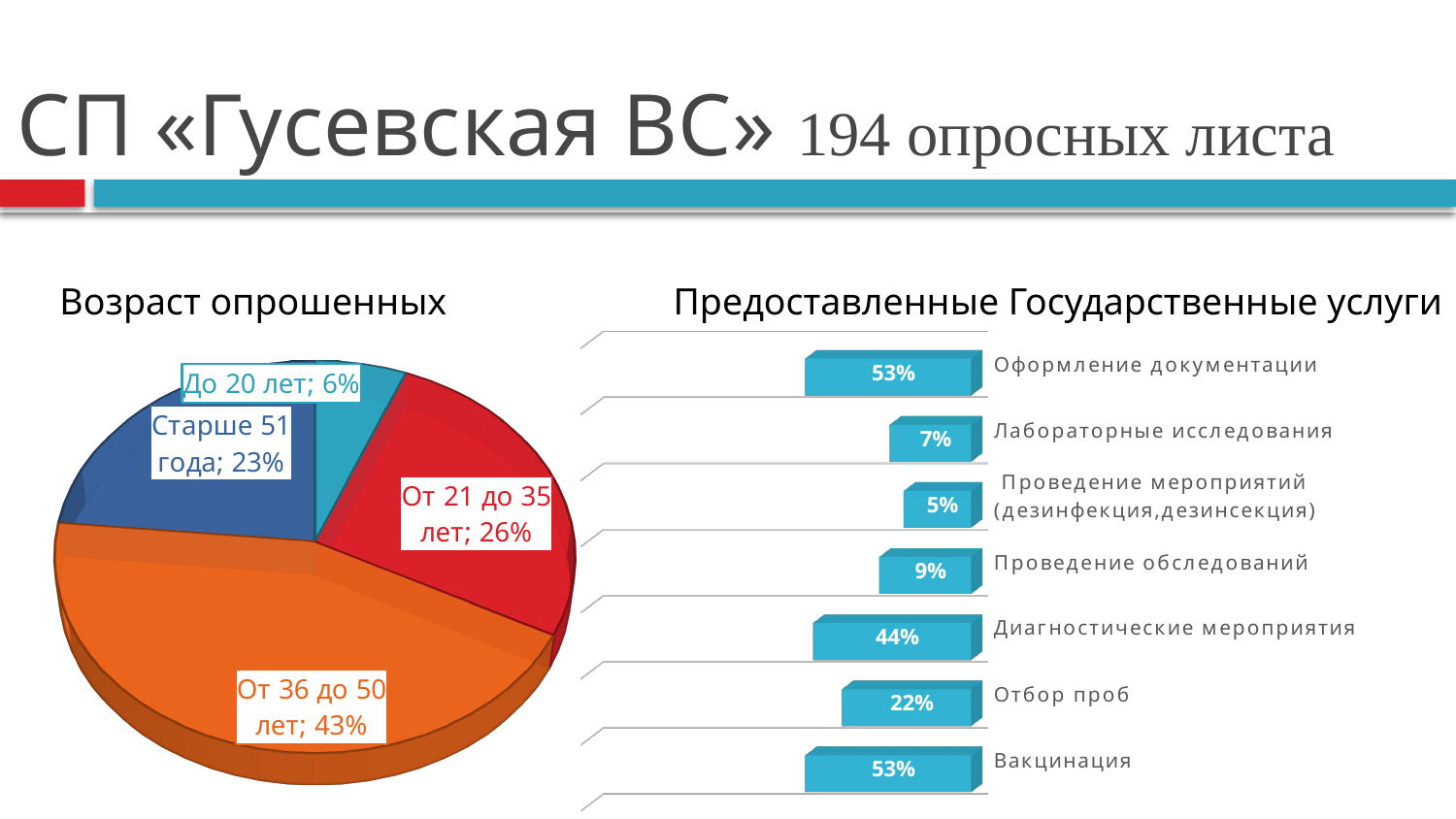
In the chart 'Предоставленные Государственные услуги', how many services are listed? 7 In the pie chart 'Возраст опрошенных', what share of respondents are 'До 20 лет'? 6% In the pie chart 'Возраст опрошенных', how many age groups are shown? 4 In the chart 'Предоставленные Государственные услуги', what is the value for 'Отбор проб'? 22% What kind of chart is 'Предоставленные Государственные услуги'? Bar chart In the chart 'Предоставленные Государственные услуги', which is larger: 'Лабораторные исследования' or 'Проведение обследований'? Проведение обследований In the chart 'Предоставленные Государственные услуги', what is the value for 'Диагностические мероприятия'? 44% In the pie chart 'Возраст опрошенных', which age group has the smallest share? До 20 лет In the chart 'Предоставленные Государственные услуги', which service has the lowest value? Проведение мероприятий (дезинфекция,дезинсекция) In the pie chart 'Возраст опрошенных', what share of respondents are aged 'От 36 до 50 лет'? 43% In the pie chart 'Возраст опрошенных', which age group has the largest share? От 36 до 50 лет In the pie chart 'Возраст опрошенных', what is the difference in percentage points between 'От 21 до 35 лет' and 'Старше 51 года'? 3